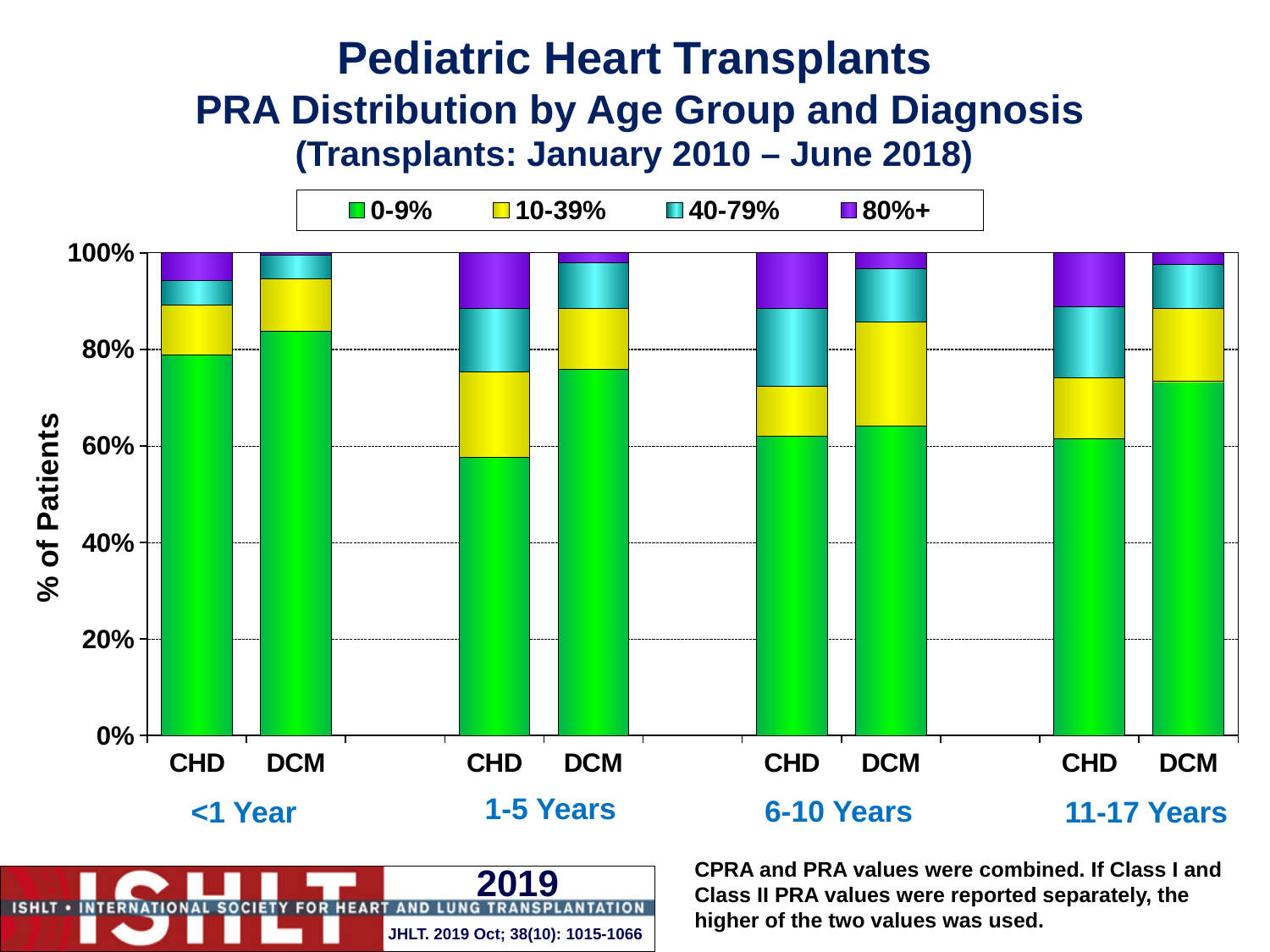
How many age groups are shown along the x axis? 4 Is the 0-9% share for DCM in the 11-17 Years group greater or less than 60%? greater Is the 0-9% share for CHD in the 1-5 Years group greater or less than 80%? less How many series does the legend list? 4 In the 11-17 Years group, which diagnosis has the larger 0-9% segment, CHD or DCM? DCM What is the label of the y axis? % of Patients Is the 0-9% share for DCM in the <1 Year group greater or less than 80%? greater Which bar has the largest 0-9% (green) segment? DCM, <1 Year What kind of chart is shown on the slide? Stacked bar chart In the 1-5 Years group, which diagnosis has the larger 0-9% segment, CHD or DCM? DCM Which colour represents the 80%+ PRA category in the legend? Purple How many bars are plotted in the chart? 8